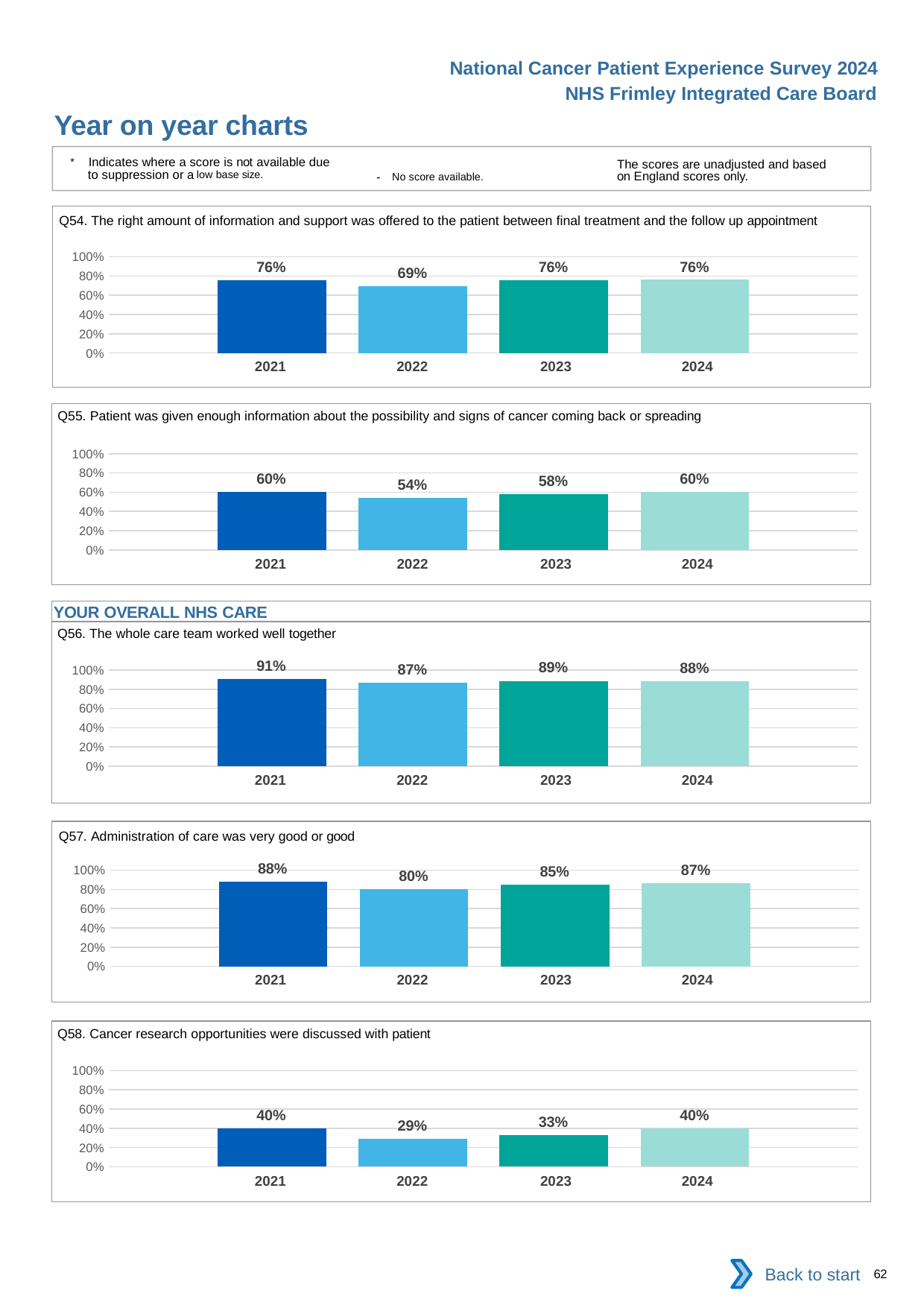
What kind of chart is the Q55 chart? bar chart In the Q57 chart, what is the difference between the 2021 and 2022 values? 8% In the Q57 chart, do the values rise or fall from 2022 to 2024? rise In the Q56 chart, what is the difference between the 2023 and 2024 values? 1% In the Q58 chart, what is the value for 2023? 33% In the Q55 chart, what is the value for 2024? 60% What is the section heading shown above the Q56 chart? YOUR OVERALL NHS CARE In the Q55 chart, which year has the lowest value? 2022 In the Q54 chart, what is the value for 2022? 69% In the Q56 chart, which year has the highest value? 2021 How many years are shown in the Q57 chart? 4 In the Q58 chart, which is larger, the value for 2022 or the value for 2024? 2024